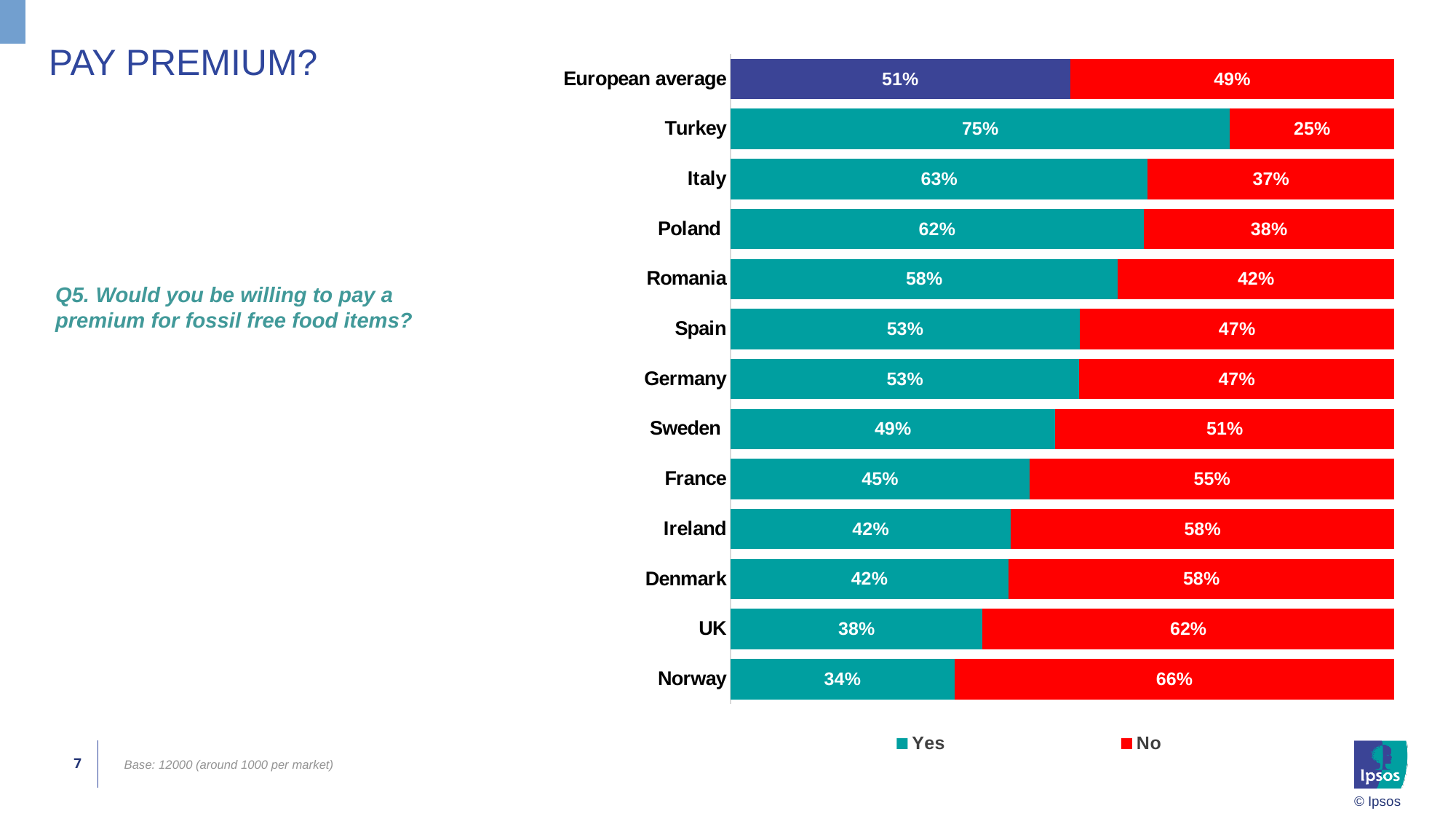
Which has a larger Yes value, France or Romania? Romania What is the difference between the Yes values for Italy and the UK? 25 percentage points Which country has the lowest Yes percentage? Norway Which country has the highest Yes percentage? Turkey What colour represents the No series in the chart? Red What is the total of the Yes and No values for Sweden? 100% How many series does the legend list? 2 How many categories (rows) are shown in the chart? 13 What percentage of respondents in Turkey answered Yes? 75% What kind of chart is shown on the slide? Stacked bar chart What is the No value for Norway? 66% What is the Yes value for the European average? 51%